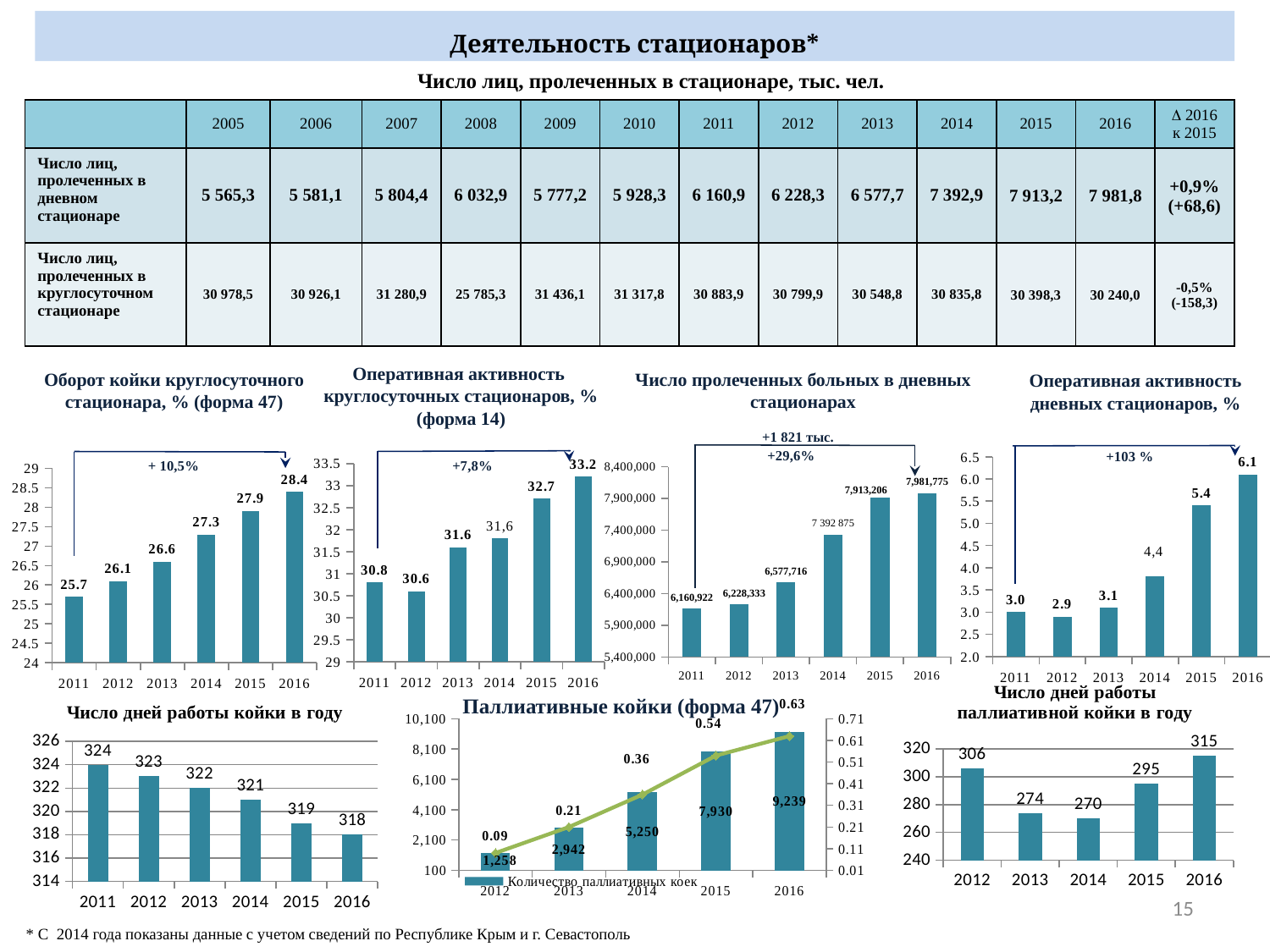
In the chart 'Число дней работы койки в году', do the values rise or fall from 2011 to 2016? fall In the chart 'Оборот койки круглосуточного стационара, % (форма 47)', what is the value for 2014? 27.3 In the chart 'Число дней работы паллиативной койки в году', which year has the highest value? 2016 In the chart 'Оперативная активность круглосуточных стационаров, % (форма 14)', what is the value for 2016? 33.2 In the chart 'Оперативная активность дневных стационаров, %', what is the difference between the values for 2016 and 2011? 3.1 In the chart 'Паллиативные койки (форма 47)', what is the bar value for 2015? 7,930 In the chart 'Число пролеченных больных в дневных стационарах', how many years are plotted? 6 In the chart 'Оперативная активность дневных стационаров, %', what is the value for 2015? 5.4 In the chart 'Число пролеченных больных в дневных стационарах', what is the value for 2013? 6,577,716 What type of chart is 'Число дней работы паллиативной койки в году'? bar chart In the chart 'Оперативная активность круглосуточных стационаров, % (форма 14)', which is larger, the value for 2011 or the value for 2012? 2011 In the chart 'Оборот койки круглосуточного стационара, % (форма 47)', which year has the lowest value? 2011